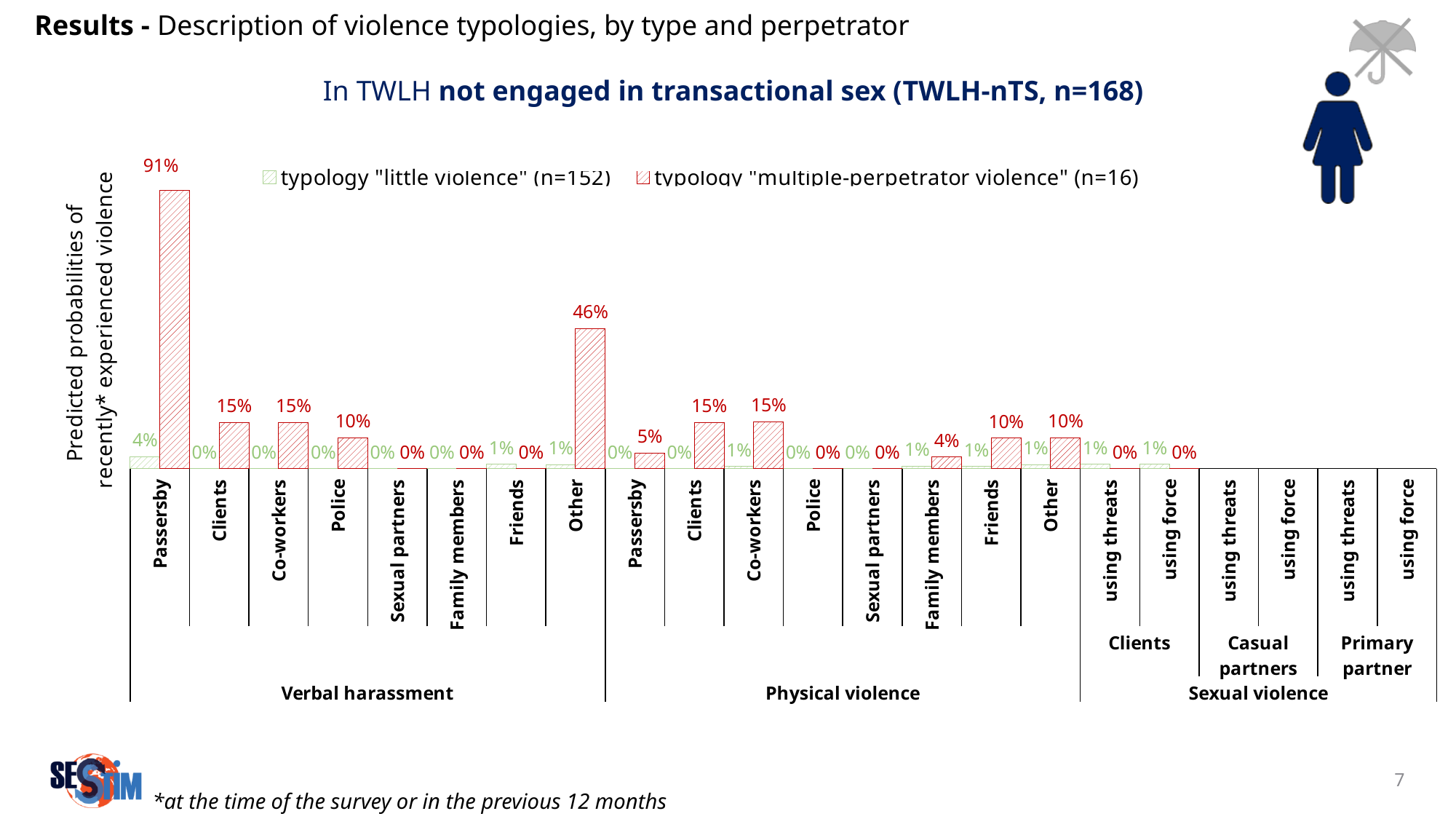
What is the value for the "multiple-perpetrator violence" typology for Family members under Physical violence? 4% What is the difference between the "multiple-perpetrator violence" and "little violence" values for Clients under Physical violence? 15% What is the value for the "multiple-perpetrator violence" typology for Other under Verbal harassment? 46% What kind of chart is shown on the slide? bar chart Which is larger for Police under Verbal harassment: the "little violence" value or the "multiple-perpetrator violence" value? multiple-perpetrator violence Which perpetrator category has the highest value for the "multiple-perpetrator violence" typology? Passersby (Verbal harassment) What is the value for the "multiple-perpetrator violence" typology for Passersby under Physical violence? 5% What is the difference between the "multiple-perpetrator violence" values for Passersby and Other under Verbal harassment? 45% What is the sample size (n) given in the legend for the "little violence" typology? 152 How many series does the legend list? 2 What is the value for the "multiple-perpetrator violence" typology for Passersby under Verbal harassment? 91% What is the value for the "little violence" typology for Passersby under Verbal harassment? 4%